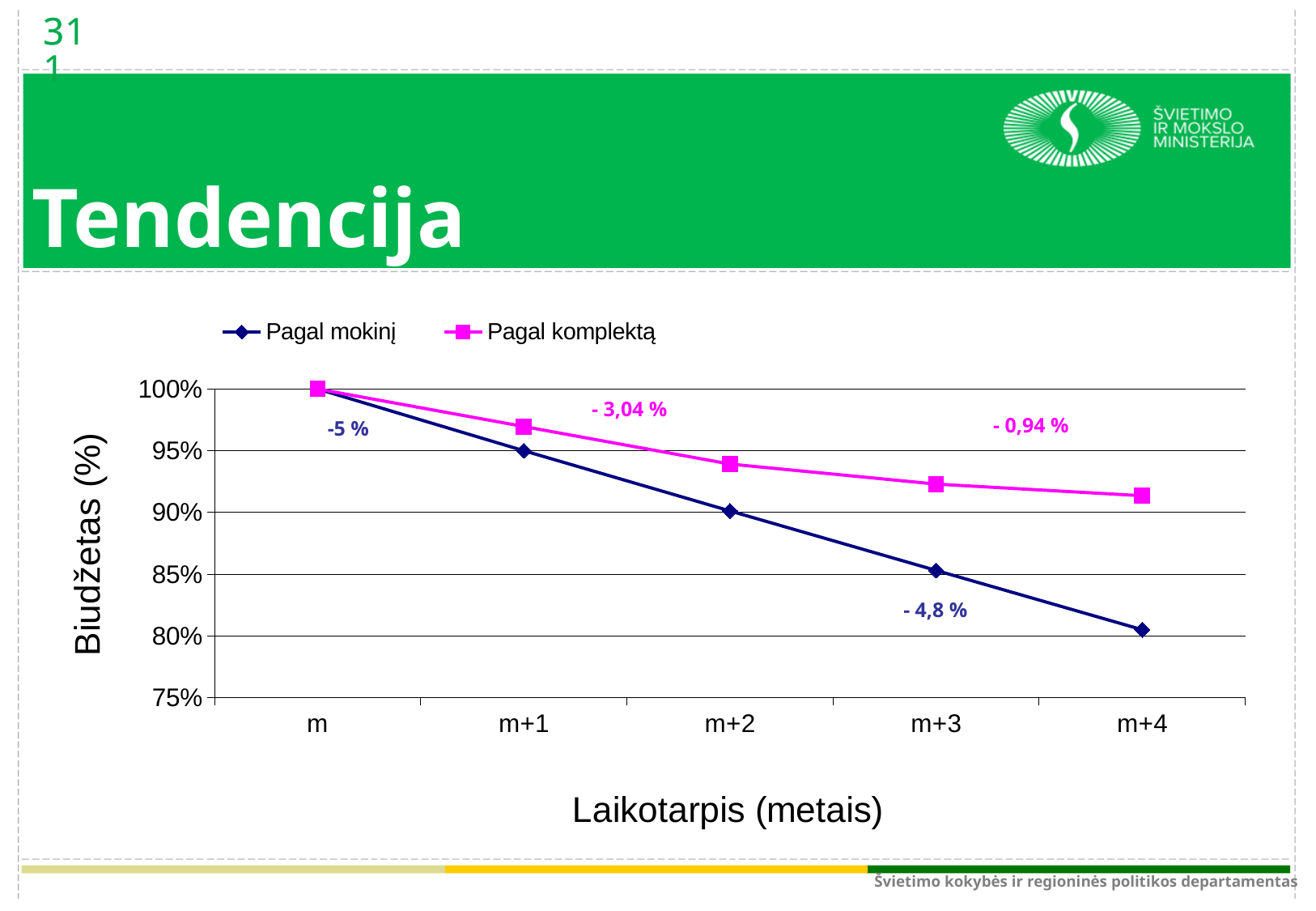
How many series does the legend list? 2 Which series has the higher value at m+3, Pagal mokinį or Pagal komplektą? Pagal komplektą What kind of chart is shown on the slide? line chart Is the value for Pagal mokinį at m+4 greater or less than 85%? less What is the value for Pagal mokinį at m? 100% What is the value for Pagal mokinį at m+1? 95% Do the values for Pagal mokinį rise or fall from m to m+4? fall Is the value for Pagal komplektą at m+2 greater or less than 95%? less What is the label of the x axis? Laikotarpis (metais) How many points are plotted along the x axis for each series? 5 Is the value for Pagal komplektą at m+4 greater or less than 90%? greater